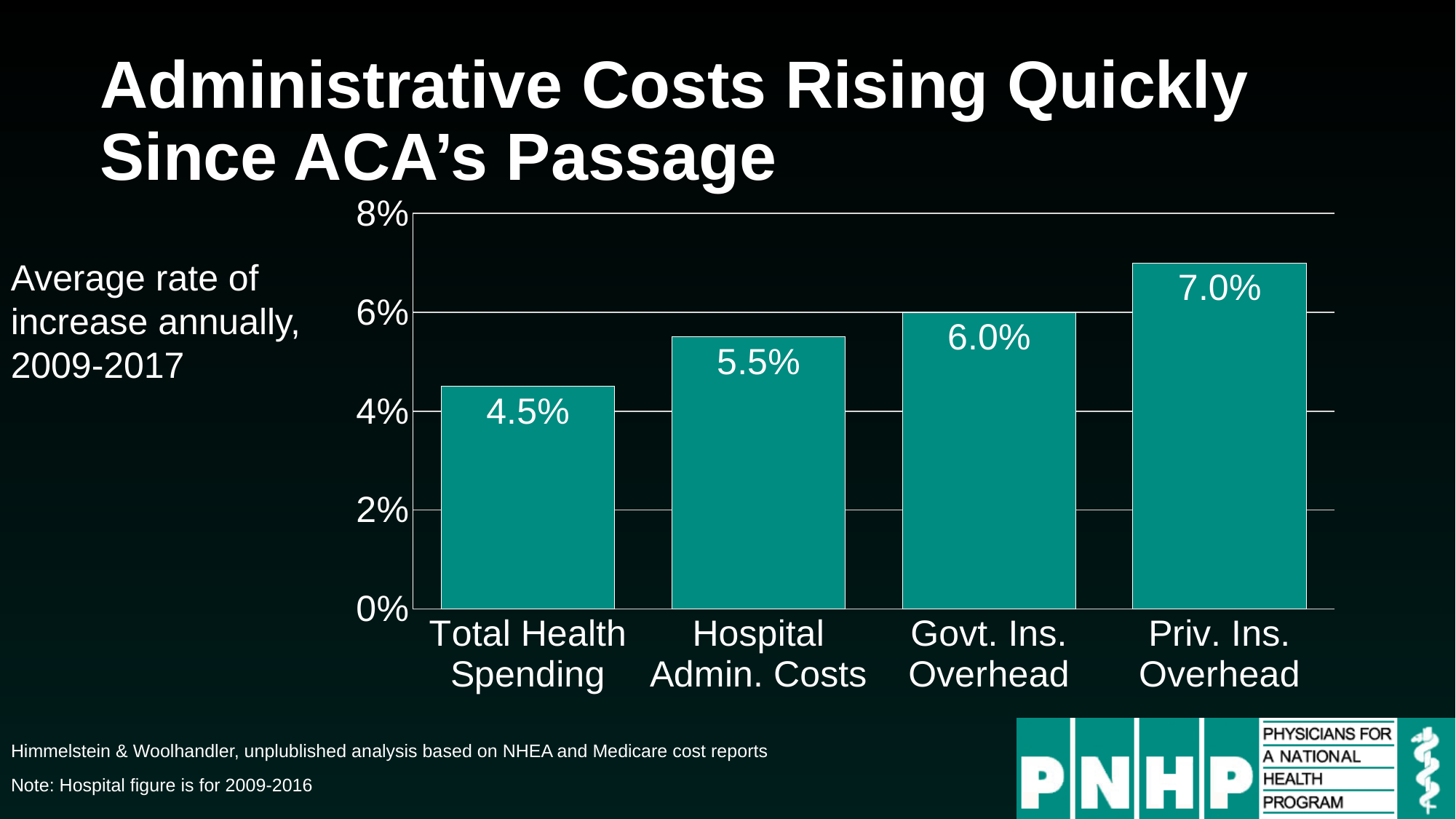
Which is larger, the value for Govt. Ins. Overhead or Hospital Admin. Costs? Govt. Ins. Overhead Is the value for Hospital Admin. Costs greater or less than 4%? greater What kind of chart is shown on the slide? Bar chart What is the value shown for Govt. Ins. Overhead? 6.0% Which category has the lowest average annual rate of increase? Total Health Spending What is the difference between the values for Priv. Ins. Overhead and Total Health Spending? 2.5% What is the value shown for Priv. Ins. Overhead? 7.0% What is the average annual rate of increase for Total Health Spending? 4.5% Do the values rise or fall from left to right across the categories? Rise How many categories are shown in the chart? 4 What is the value shown for Hospital Admin. Costs? 5.5% Which category has the highest average annual rate of increase? Priv. Ins. Overhead